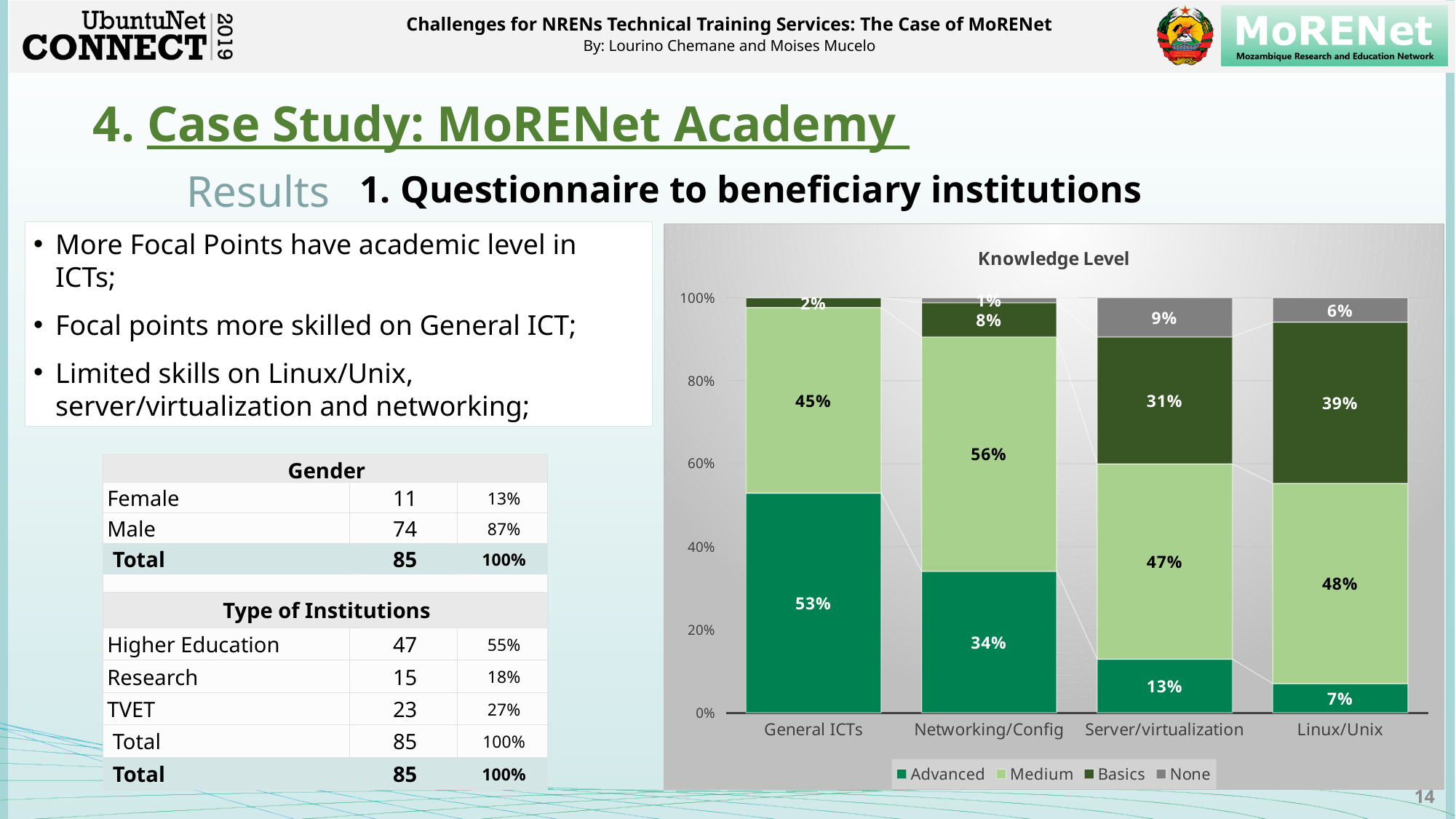
How many series does the chart legend list? 4 Which category has the lowest Advanced value? Linux/Unix Which category has the highest Advanced value? General ICTs What is the Basics value for Linux/Unix? 39% What is the Medium value for Networking/Config? 56% How many categories are shown on the x axis of the chart? 4 What is the title of the chart? Knowledge Level Does the Advanced value rise or fall across the categories from General ICTs to Linux/Unix? Fall What is the None value for Server/virtualization? 9% What is the difference between the Basics values for Linux/Unix and Server/virtualization? 8% What type of chart is shown on the slide? Stacked bar chart What is the Advanced value for General ICTs? 53%